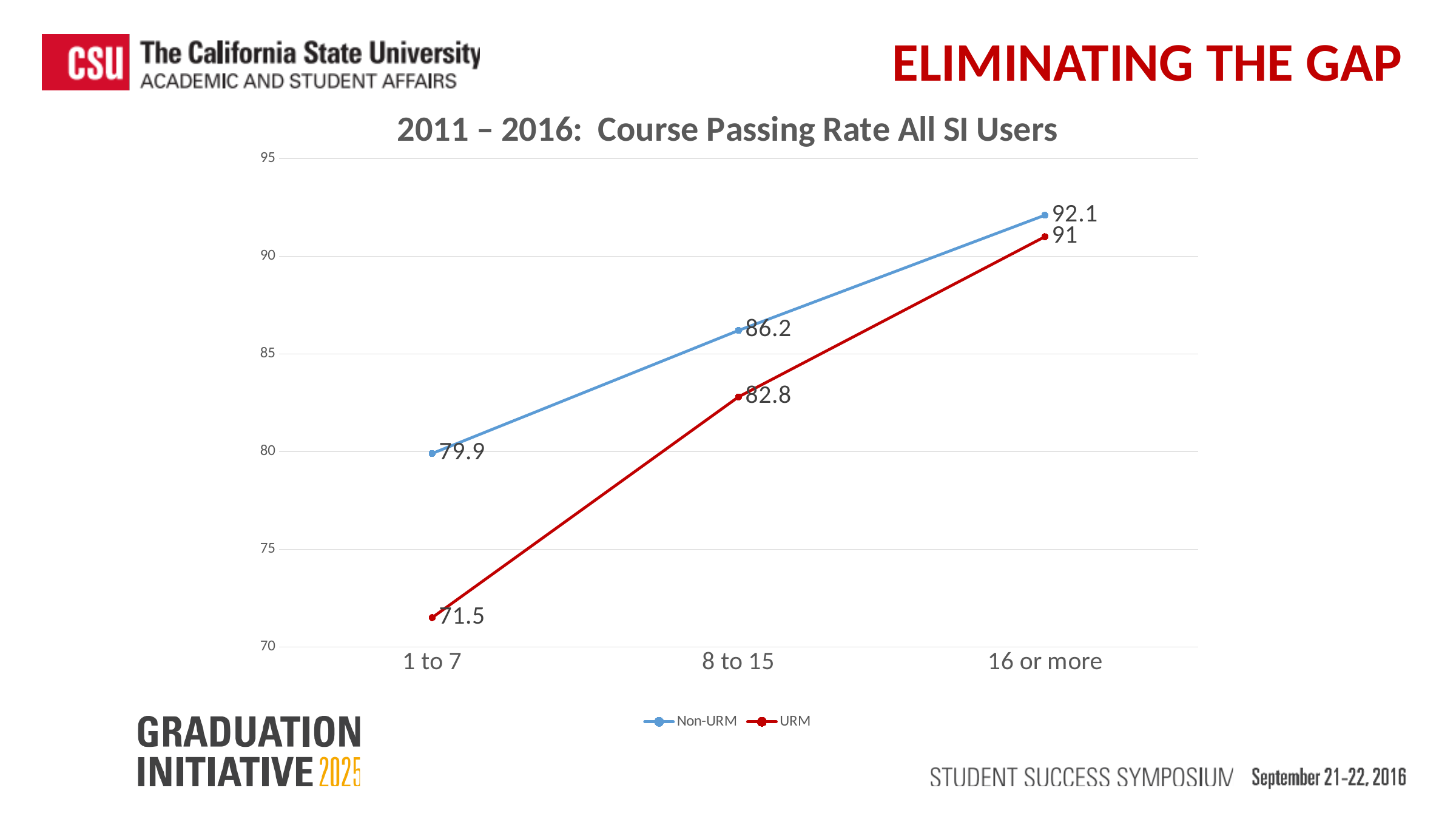
What is the course passing rate for Non-URM students in the 1 to 7 category? 79.9 How many categories are shown on the x axis? 3 What kind of chart is shown on the slide? Line chart What is the course passing rate for Non-URM students in the 8 to 15 category? 86.2 What is the course passing rate for URM students in the 8 to 15 category? 82.8 Which category has the highest Non-URM passing rate? 16 or more What is the course passing rate for URM students in the 16 or more category? 91 Which is larger in the 8 to 15 category, the Non-URM or the URM passing rate? Non-URM What is the difference between the Non-URM and URM passing rates in the 1 to 7 category? 8.4 What is the difference between the Non-URM and URM passing rates in the 16 or more category? 1.1 Which category has the lowest URM passing rate? 1 to 7 How many series does the legend list? 2